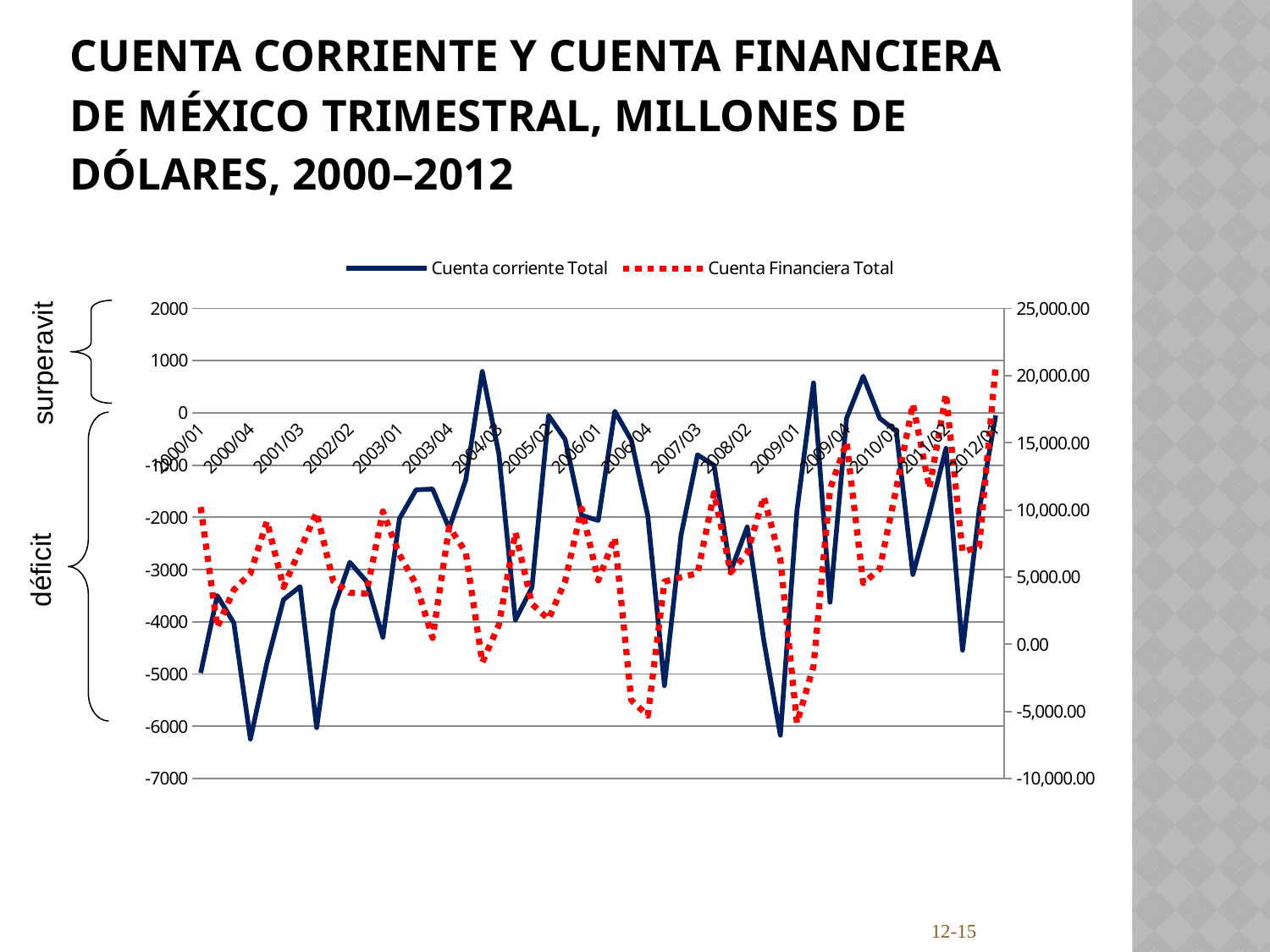
Is the value of Cuenta corriente Total at 2000/01 greater or less than -4000? less Is the value of Cuenta Financiera Total at 2000/01 greater or less than 5,000.00? greater Is the value of Cuenta corriente Total at 2012/01 greater or less than -1000? greater How many series does the legend list? 2 What are the two series named in the legend? Cuenta corriente Total and Cuenta Financiera Total What kind of chart is shown on the slide? line chart Which series is drawn as a dashed red line? Cuenta Financiera Total How many quarter labels are printed along the x axis? 17